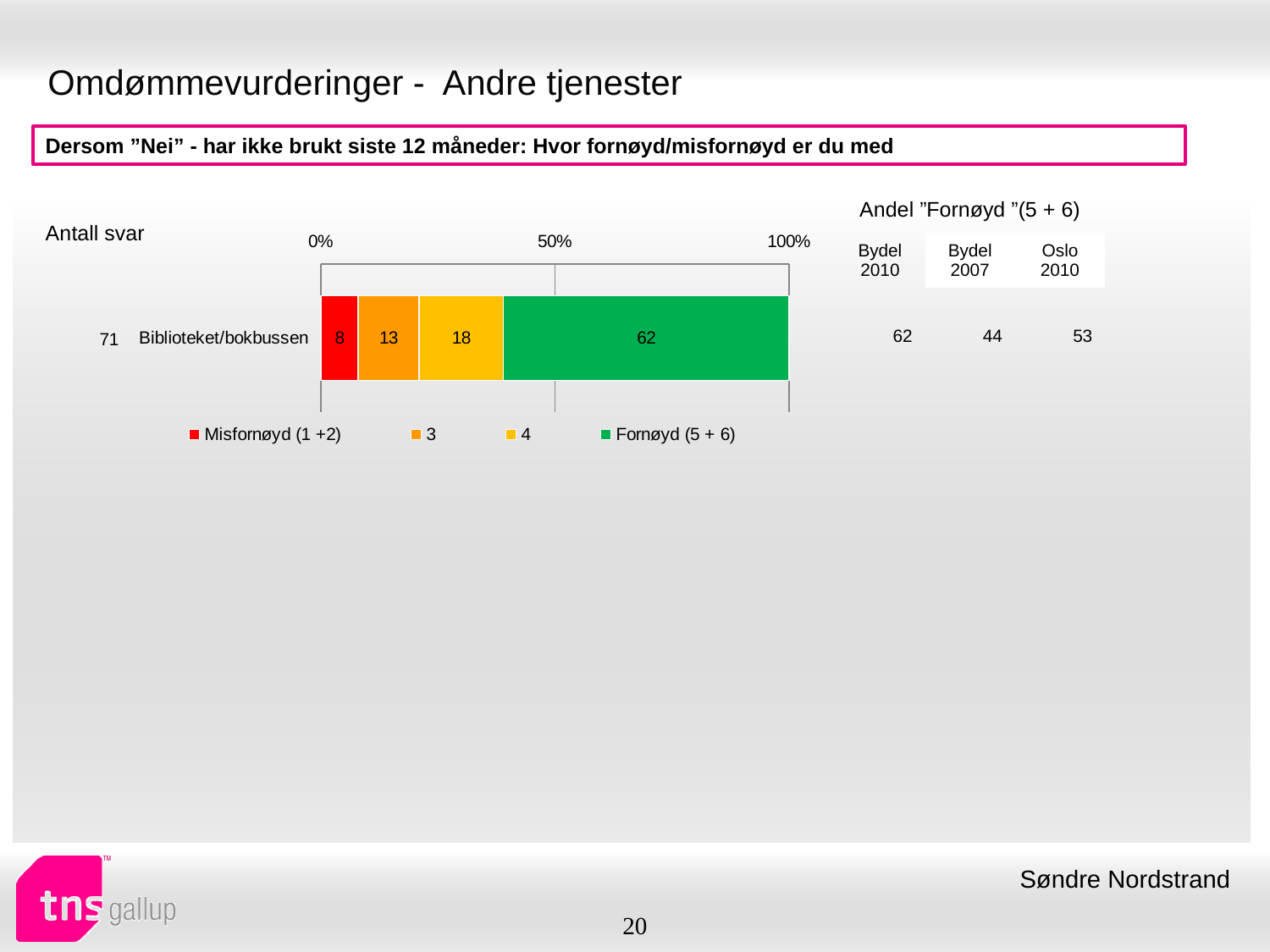
What is the value of the "3" segment for Biblioteket/bokbussen? 13 How many categories are plotted in the chart? 1 Which segment of the Biblioteket/bokbussen bar has the smallest value? Misfornøyd (1 +2) Which is larger for Biblioteket/bokbussen, the "3" segment or the "4" segment? 4 What is the value of the "4" segment for Biblioteket/bokbussen? 18 What is the number of responses (Antall svar) shown for Biblioteket/bokbussen? 71 What kind of chart is shown on the slide? Stacked bar chart How many series does the legend list? 4 What is the value of the "Fornøyd (5 + 6)" segment for Biblioteket/bokbussen? 62 What is the difference between the "Fornøyd (5 + 6)" segment and the "4" segment for Biblioteket/bokbussen? 44 Which segment of the Biblioteket/bokbussen bar has the largest value? Fornøyd (5 + 6) What is the value of the "Misfornøyd (1 +2)" segment for Biblioteket/bokbussen? 8